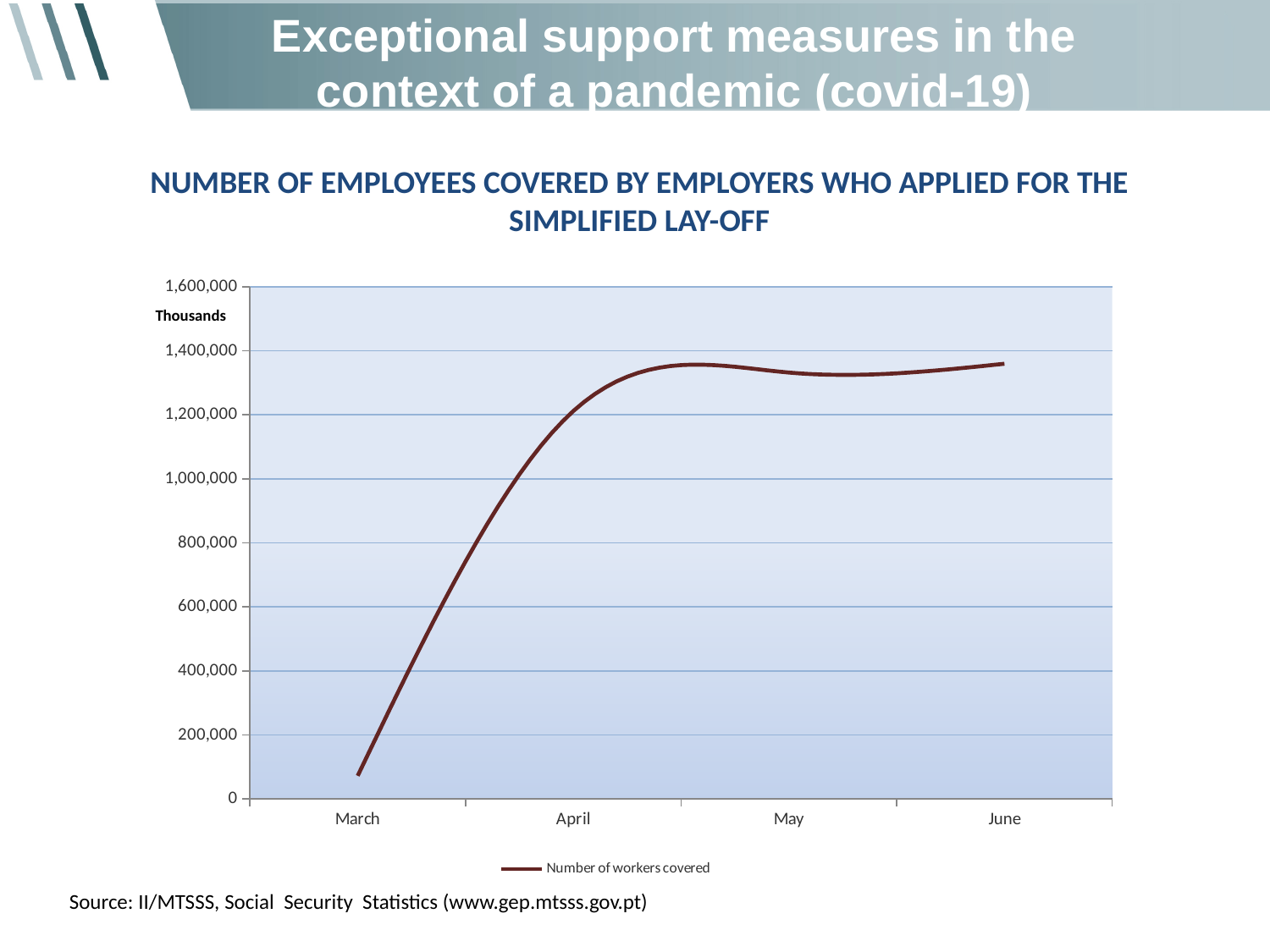
How many series does the chart's legend list? 1 Is the value for June greater or less than 1,200,000? greater Is the value for May greater or less than 1,400,000? less Which is larger, the value for March or the value for April? April Does the number of workers covered rise or fall from March to April? rise Which month has the lowest number of workers covered? March Is the value for March greater or less than 200,000? less What is the name of the series shown in the chart's legend? Number of workers covered How many months are plotted along the x axis of the chart? 4 What is the title of the chart? NUMBER OF EMPLOYEES COVERED BY EMPLOYERS WHO APPLIED FOR THE SIMPLIFIED LAY-OFF What kind of chart is shown on the slide? line chart